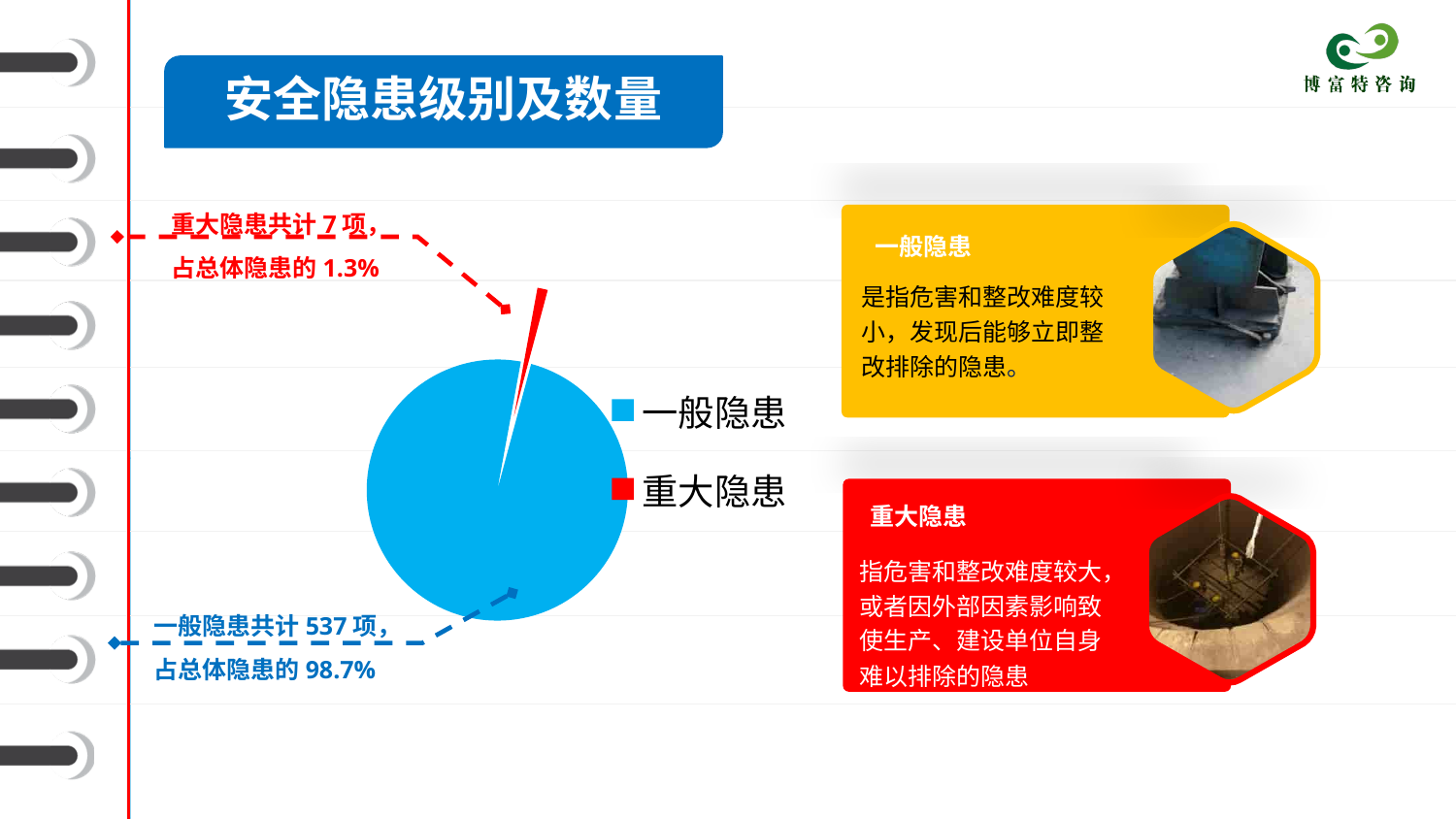
How many categories does the pie chart have? 2 According to the annotation, how many items are 重大隐患? 7 项 What kind of chart is shown on the slide? pie chart According to the annotation, how many items are 一般隐患? 537 项 Which category has the smallest slice of the pie chart? 重大隐患 What share of the total hazards does 一般隐患 account for? 98.7% What is the difference in item count between 一般隐患 and 重大隐患? 530 What colour represents 重大隐患 in the pie chart? red Which category has the largest slice of the pie chart? 一般隐患 How many entries does the legend of the pie chart list? 2 What is the total number of hazard items represented in the pie chart? 544 What share of the total hazards does 重大隐患 account for? 1.3%